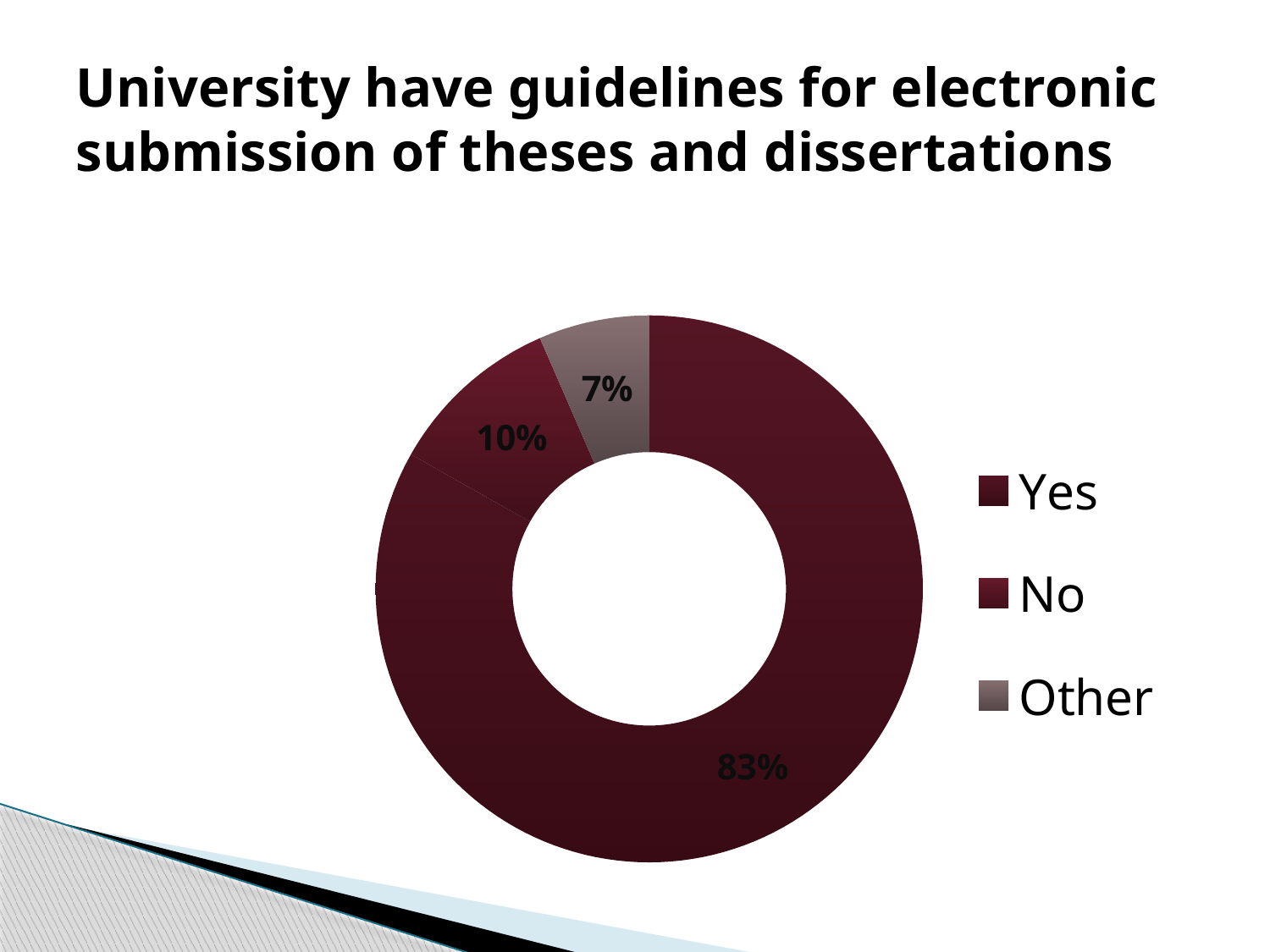
What is the title of the slide? University have guidelines for electronic submission of theses and dissertations Which category has the largest share of the chart? Yes Which slice is larger, No or Other? No What is the difference in percentage points between the Yes and No slices? 73 What percentage of the doughnut chart is labelled No? 10% What percentage of the doughnut chart is labelled Yes? 83% Which category has the smallest share of the chart? Other What percentage of the doughnut chart is labelled Other? 7% How many categories does the chart show? 3 What is the difference in percentage points between the No and Other slices? 3 Which legend entry is shown in grey? Other What kind of chart is shown on the slide? Doughnut (pie) chart